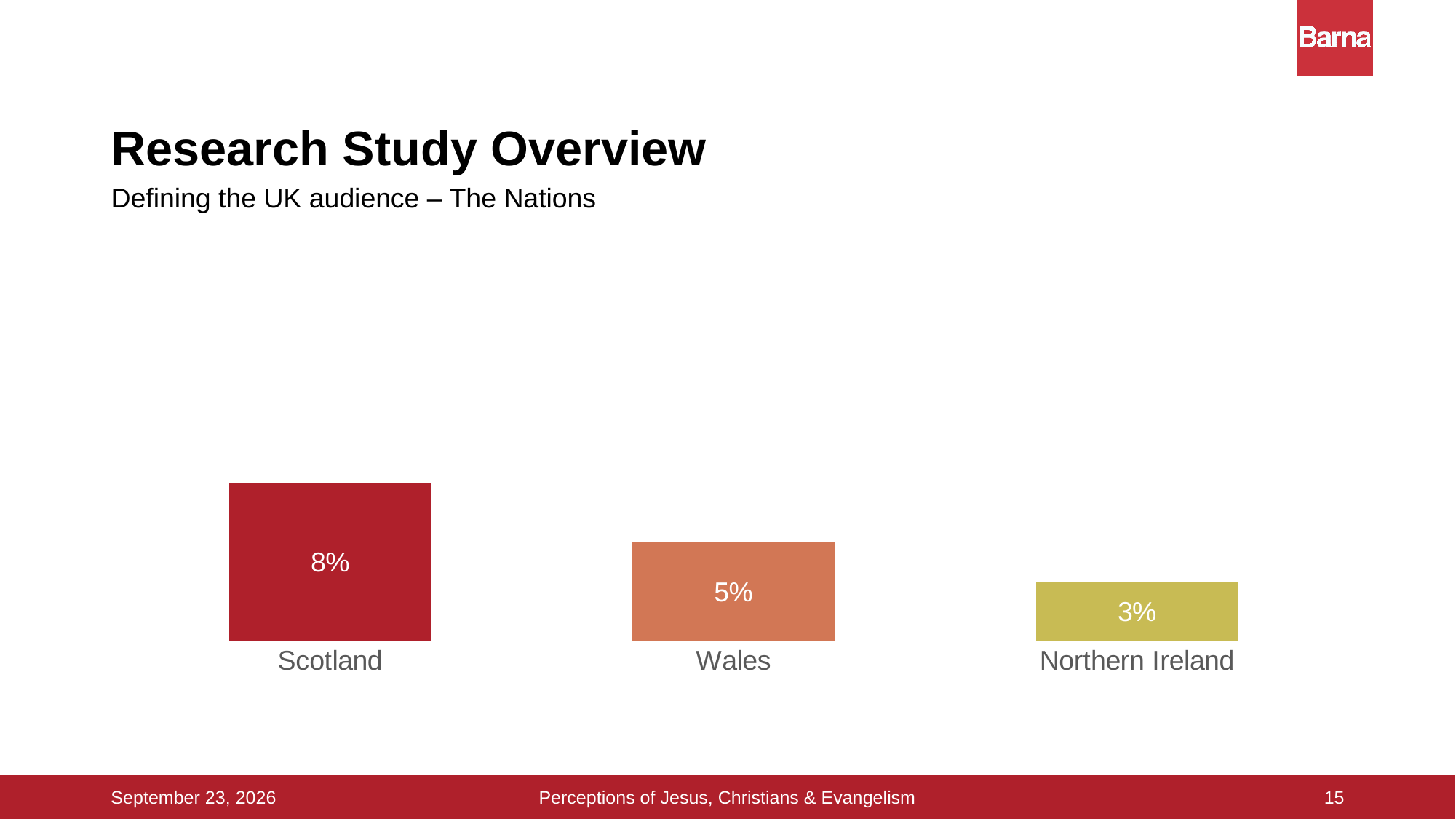
What is the difference between the values for Wales and Northern Ireland? 2% What is the value shown for Wales? 5% Do the values rise or fall from left to right across the chart? Fall What is the value shown for Scotland? 8% What is the value shown for Northern Ireland? 3% What colour is the bar for Northern Ireland? Yellow Which nation has the highest value? Scotland What is the difference between the values for Scotland and Wales? 3% Which has a larger value, Wales or Northern Ireland? Wales Which nation has the lowest value? Northern Ireland What kind of chart is shown on the slide? Bar chart How many nations are shown in the chart? 3